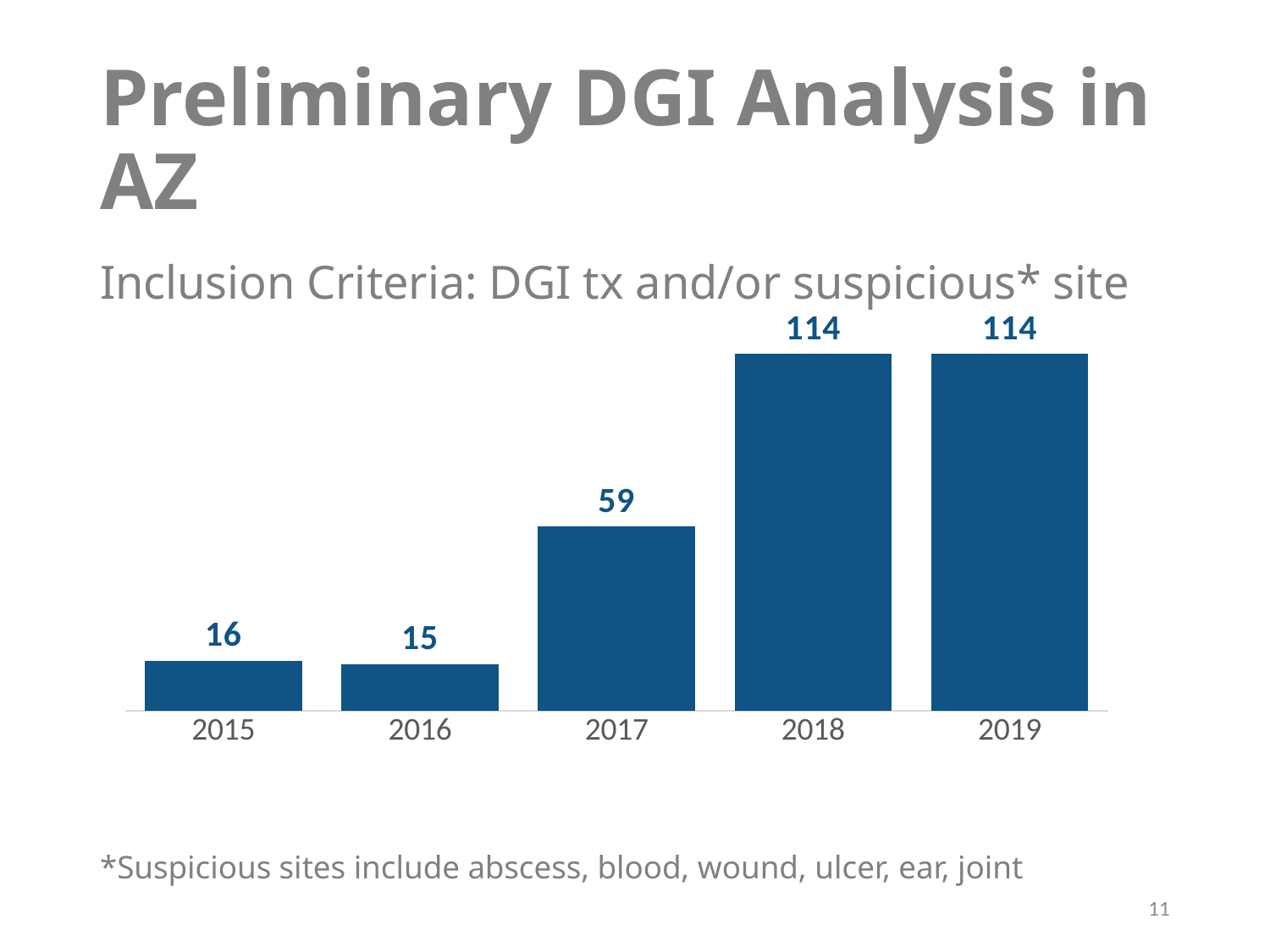
What is the total of the values for 2018 and 2019 combined? 228 Do the values generally rise or fall from 2016 to 2018? Rise What is the value for 2017? 59 How many years are shown on the x axis? 5 Which years share the highest value? 2018 and 2019 What is the value for 2015? 16 What is the difference between the values for 2015 and 2016? 1 What is the difference between the values for 2018 and 2017? 55 Which year has the lowest value? 2016 Which is larger, the value for 2015 or the value for 2016? 2015 What is the value for 2019? 114 What kind of chart is shown? Bar chart